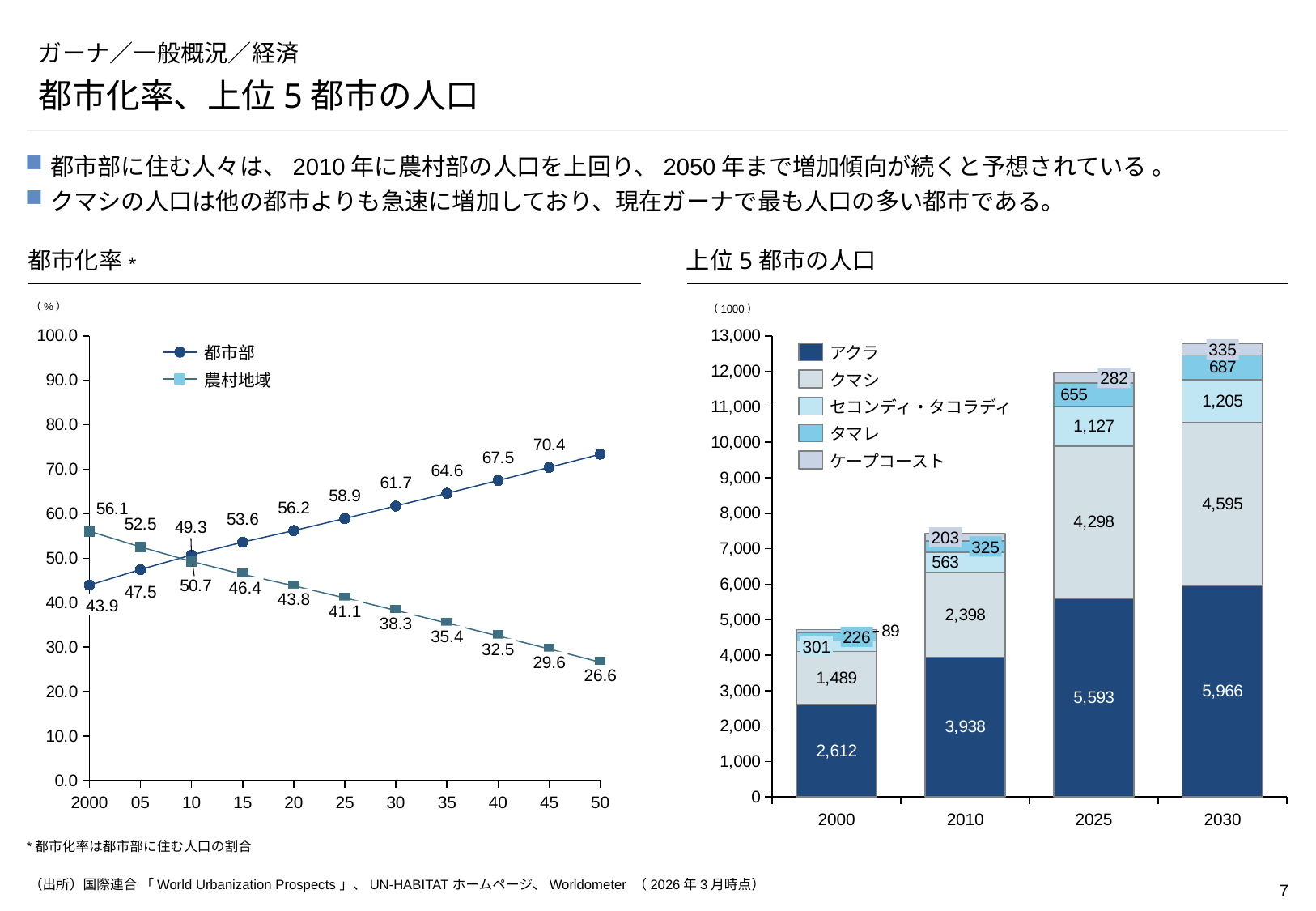
In the 都市化率 chart on the left, how many series does the legend list? 2 In the 上位5都市の人口 chart on the right, how many years are shown on the x axis? 4 In the 都市化率 chart on the left, what is the value for 農村地域 in 2050? 26.6 In the 都市化率 chart on the left, what is the difference between 都市部 and 農村地域 in 2040? 35.0 In the 上位5都市の人口 chart on the right, which city has the smallest value in 2025? ケープコースト In the 上位5都市の人口 chart on the right, what is the value for アクラ in 2010? 3,938 In the 上位5都市の人口 chart on the right, what kind of chart is shown? stacked bar chart In the 都市化率 chart on the left, what is the value for 都市部 in 2030? 61.7 In the 上位5都市の人口 chart on the right, what is the value for クマシ in 2030? 4,595 In the 都市化率 chart on the left, what is the value for 都市部 in 2000? 43.9 In the 上位5都市の人口 chart on the right, what is the total of the stacked bar for 2000? 4,717 In the 都市化率 chart on the left, does the 農村地域 series rise or fall from 2000 to 2050? fall